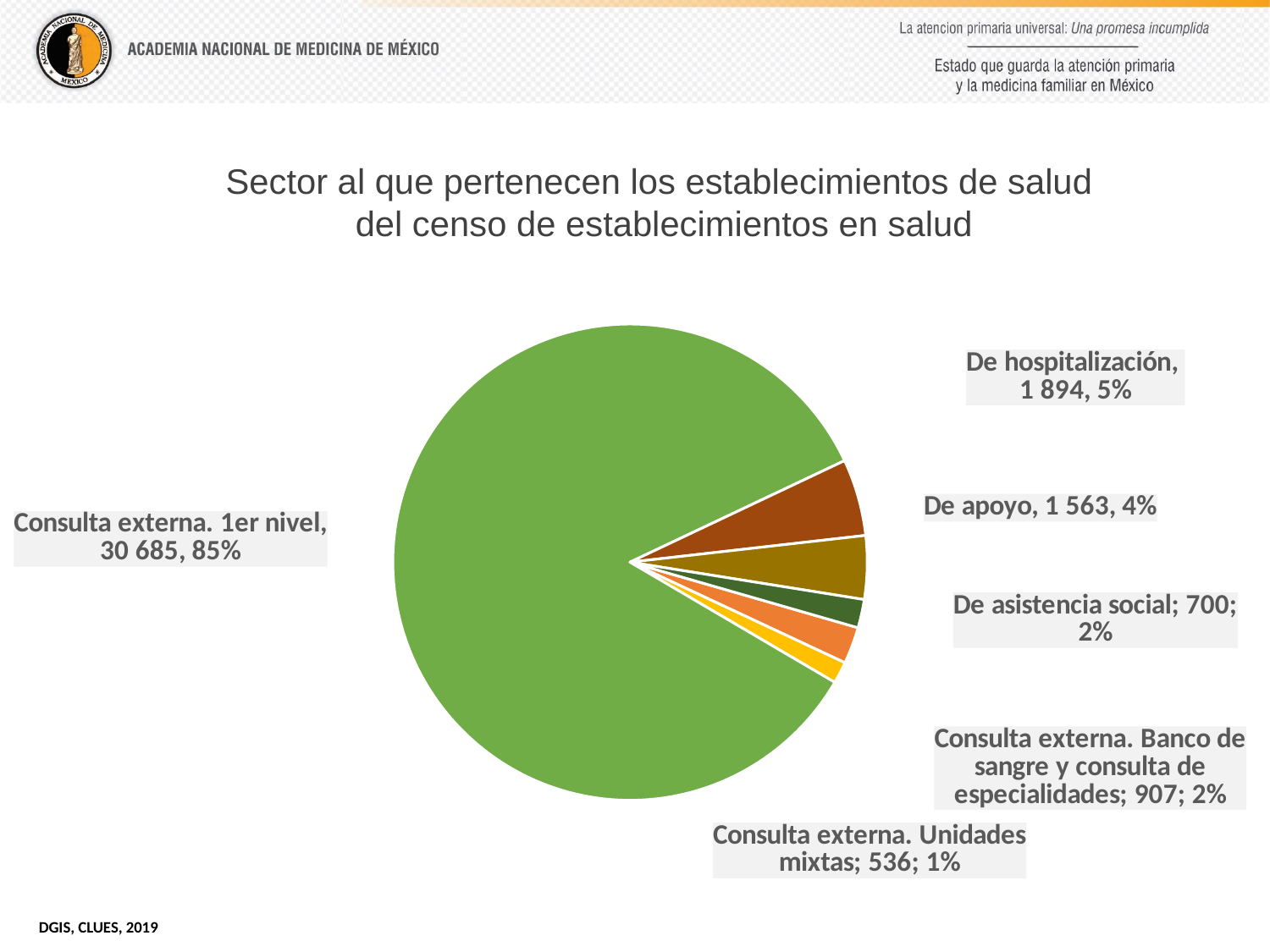
What kind of chart is shown on the slide? pie chart What is the title of the chart? Sector al que pertenecen los establecimientos de salud del censo de establecimientos en salud What is the difference between the values for 'De hospitalización' and 'De apoyo'? 331 What is the value for 'Consulta externa. 1er nivel'? 30 685 What is the value for 'De hospitalización'? 1 894 Which category has the largest slice of the pie? Consulta externa. 1er nivel How many slices does the pie chart have? 6 What percentage is shown for 'De apoyo'? 4% What share of the pie does 'Consulta externa. 1er nivel' represent? 85% Which is larger: the value for 'De asistencia social' or for 'Consulta externa. Banco de sangre y consulta de especialidades'? Consulta externa. Banco de sangre y consulta de especialidades Which category has the smallest slice of the pie? Consulta externa. Unidades mixtas What is the value for 'Consulta externa. Unidades mixtas'? 536